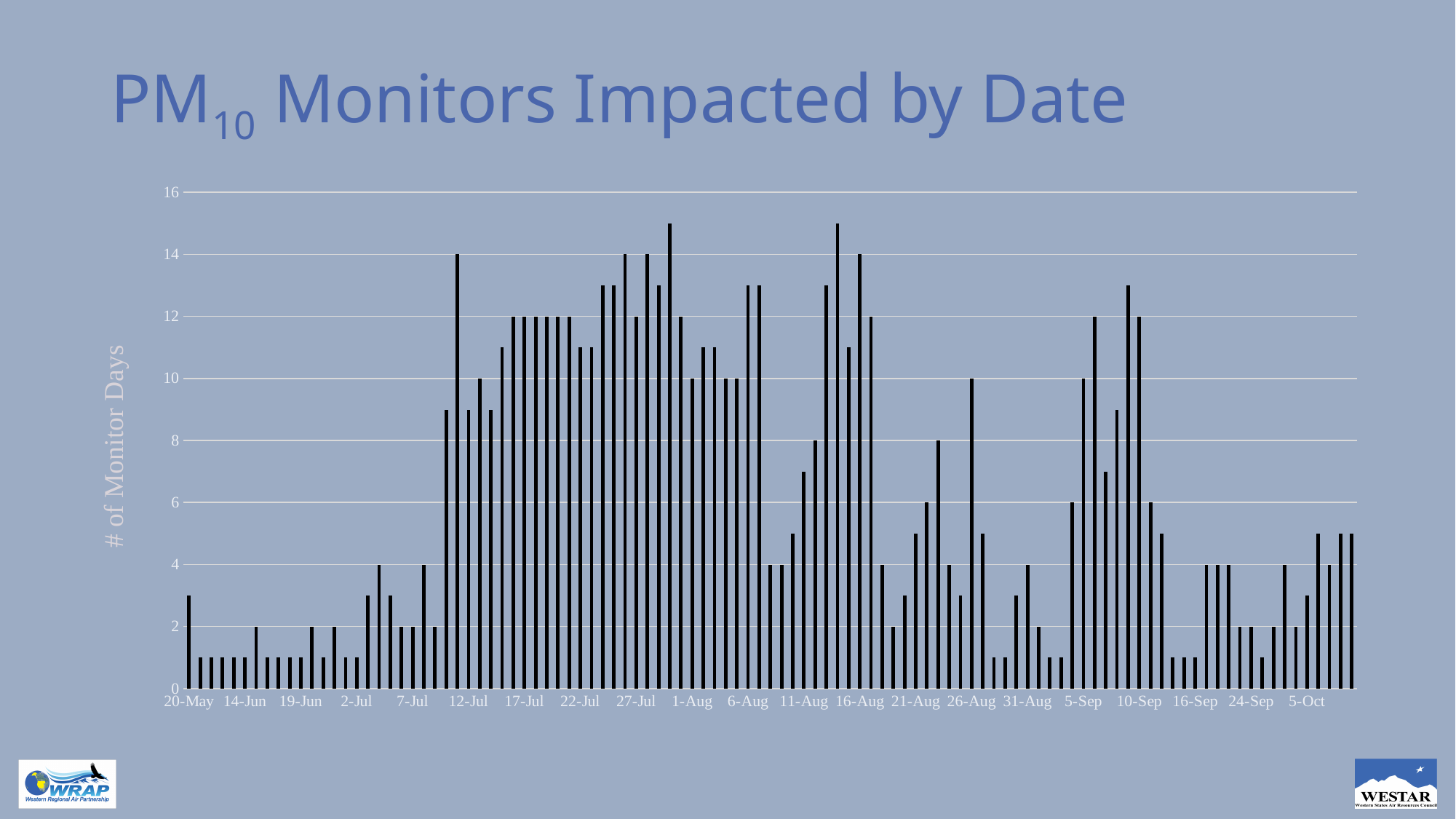
Which is larger, the value for 17-Jul or the value for 14-Jun? 17-Jul Do the values generally rise or fall from 20-May to 17-Jul? rise What kind of chart is shown on the slide? bar chart What is the title of the chart on the slide? PM10 Monitors Impacted by Date What is the label on the vertical axis of the chart? # of Monitor Days Is the highest value in the chart greater or less than 16? less Is the highest value in the chart greater or less than 14? greater Is the value for 17-Jul greater or less than 10? greater